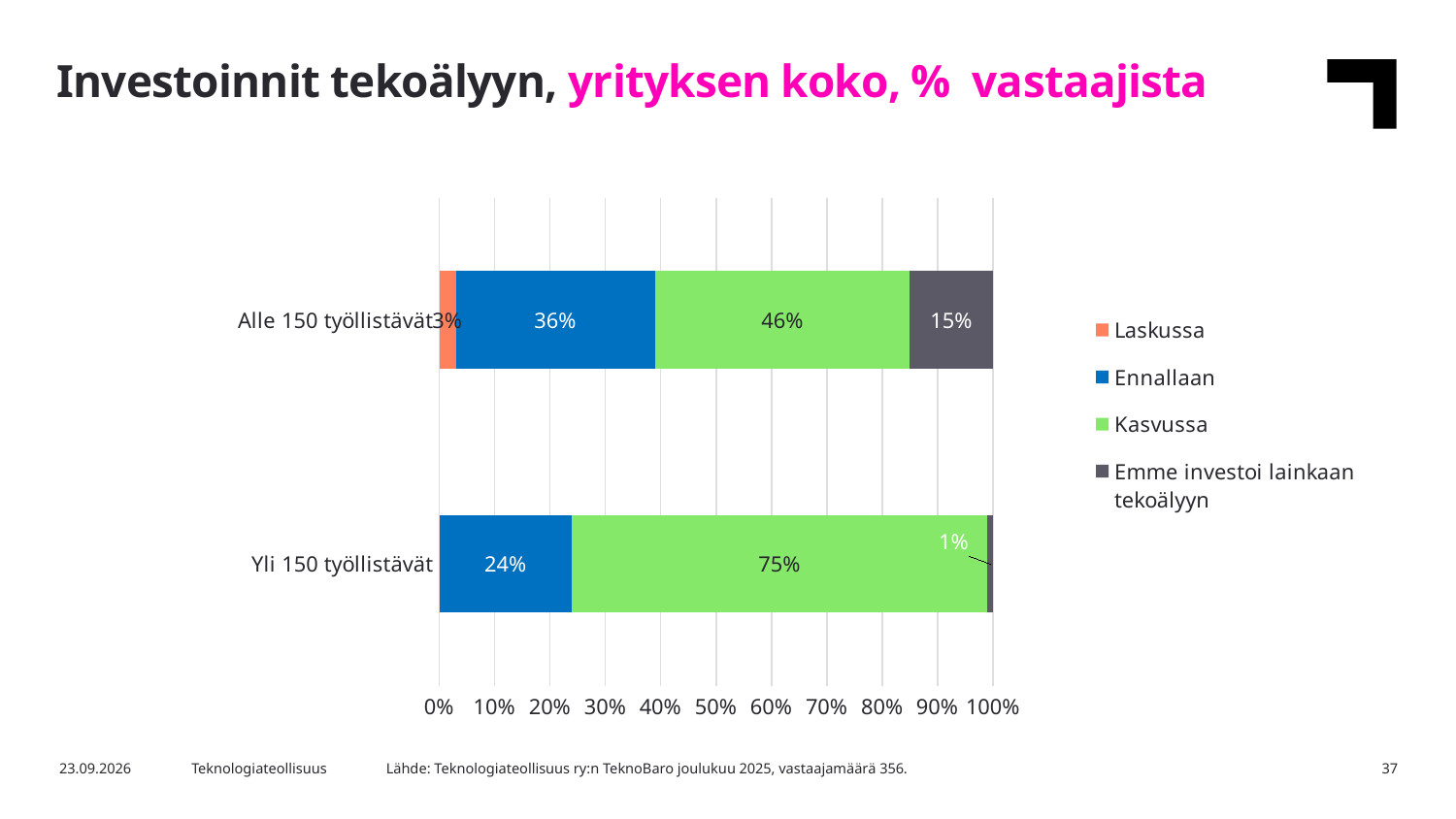
Which category has the higher Kasvussa value? Yli 150 työllistävät What is the Kasvussa value for Yli 150 työllistävät? 75% Which legend entry is shown in green? Kasvussa What is the Ennallaan value for Yli 150 työllistävät? 24% What is the difference between the Kasvussa values for Yli 150 työllistävät and Alle 150 työllistävät? 29% What kind of chart is shown on the slide? Stacked bar chart What is the Kasvussa value for Alle 150 työllistävät? 46% What is the difference between the Ennallaan values for Alle 150 työllistävät and Yli 150 työllistävät? 12% How many series does the legend list? 4 What is the Laskussa value for Alle 150 työllistävät? 3% How many categories are shown on the y axis? 2 What is the Emme investoi lainkaan tekoälyyn value for Alle 150 työllistävät? 15%